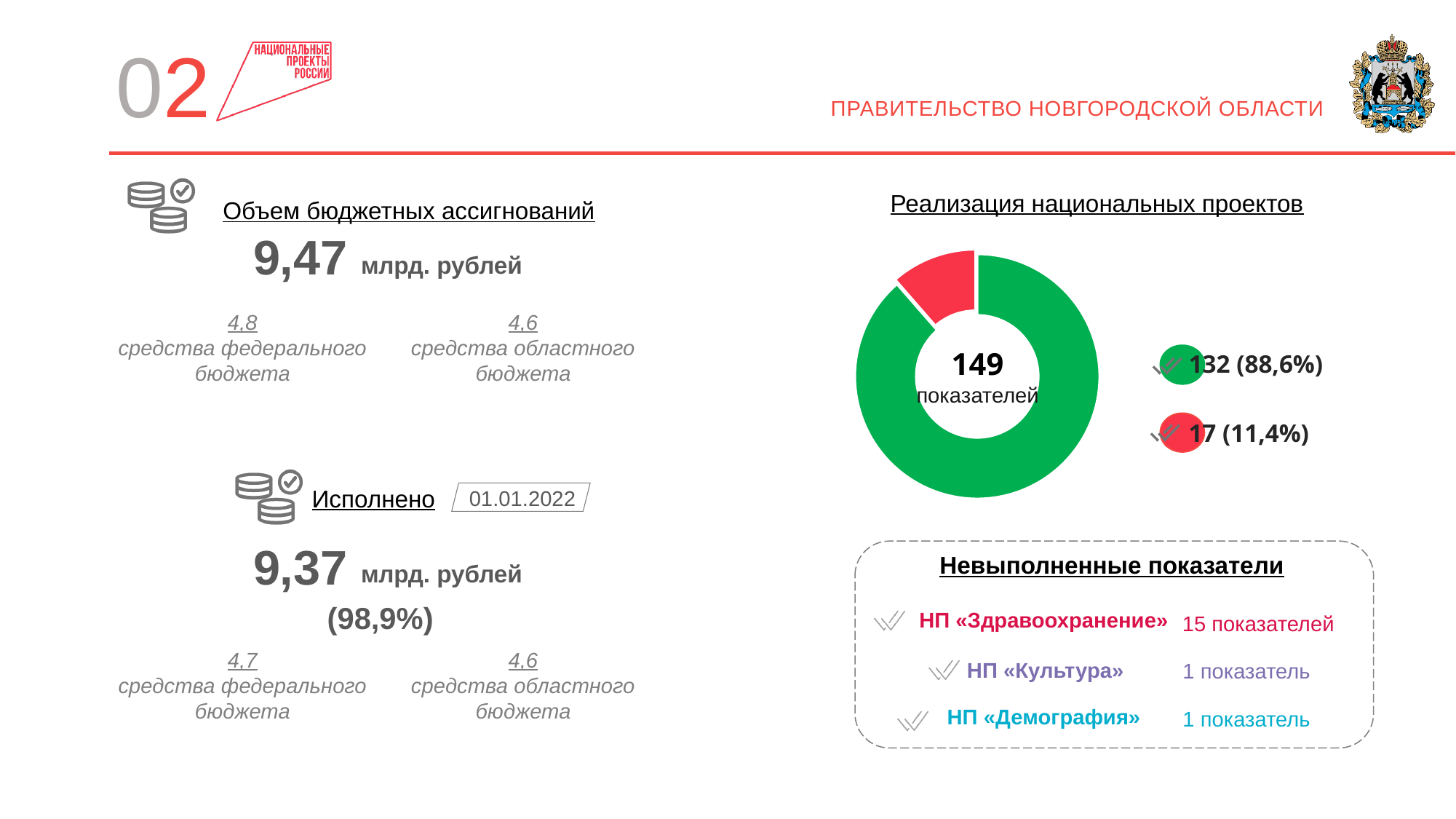
What number is printed in the centre of the donut chart? 149 показателей What is the title of the chart on the right side of the slide? Реализация национальных проектов Which colour is used for the smaller segment of the donut chart? Red What share of the donut chart does the green segment represent? 88,6% What value is shown for the red segment of the donut chart? 17 (11,4%) What kind of chart is shown under the title «Реализация национальных проектов»? Donut (pie) chart What is the difference between the green segment count (132) and the red segment count (17) in the donut chart? 115 What is the total of the two segments of the donut chart (132 + 17)? 149 What share of the donut chart does the red segment represent? 11,4% What value is shown for the green segment of the donut chart? 132 (88,6%) How many segments does the donut chart have? 2 Which segment of the donut chart is larger, the green one or the red one? The green one